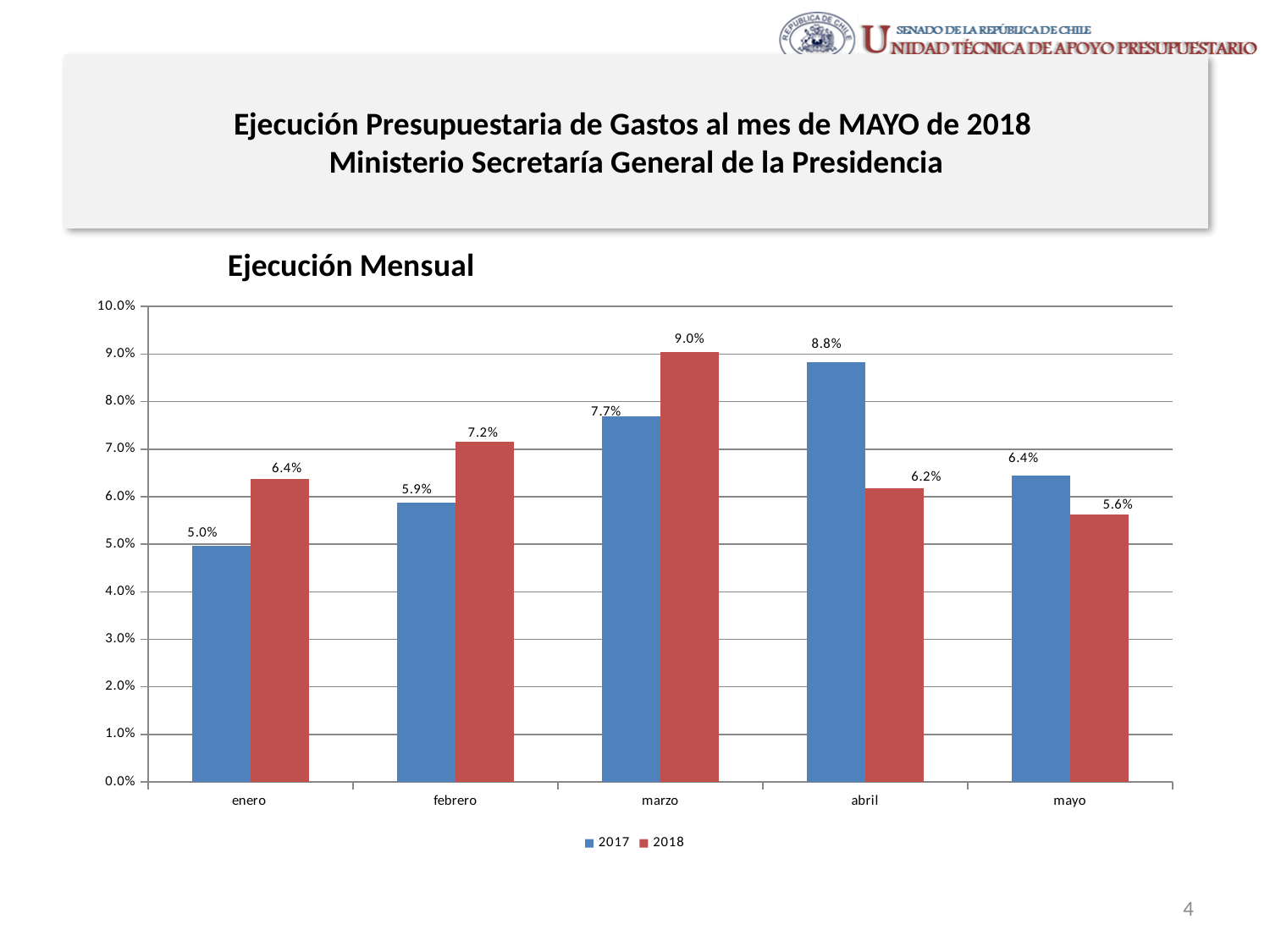
What is the value for 2017 in enero? 5.0% How many series does the legend list? 2 Which is larger in abril, the 2017 value or the 2018 value? 2017 What is the value for 2018 in marzo? 9.0% How many months are shown on the x axis? 5 Which month has the highest value for the 2017 series? abril What is the difference between the 2018 and 2017 values in febrero? 1.3% Does the 2018 series rise or fall from marzo to mayo? fall Which month has the lowest value for the 2018 series? mayo What kind of chart is shown on the slide? bar chart What is the value for 2018 in mayo? 5.6% What is the title of the chart? Ejecución Mensual